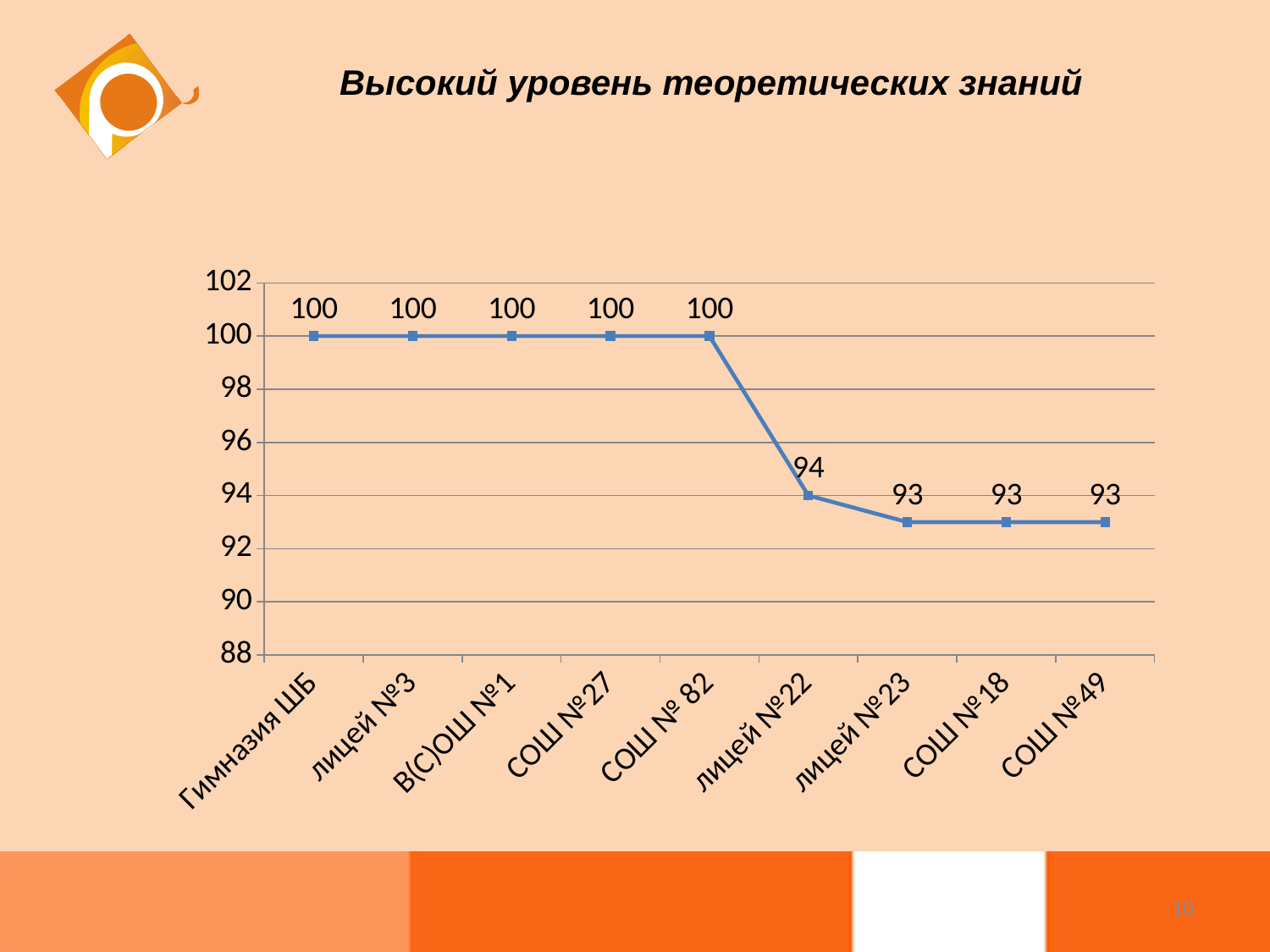
What is the difference between the values for лицей №22 and лицей №23? 1 What is the title of the slide? Высокий уровень теоретических знаний What kind of chart is shown on the slide? line chart What is the value for лицей №22? 94 How many categories are plotted on the x axis? 9 Which category has the lowest value among лицей №22, лицей №23 and СОШ №18? лицей №23 and СОШ №18 (both 93) Which is larger, the value for В(С)ОШ №1 or the value for СОШ №18? В(С)ОШ №1 What is the value for СОШ № 82? 100 Do the values rise or fall along the x axis from СОШ № 82 to СОШ №49? fall What is the value for СОШ №49? 93 What is the value for Гимназия ШБ? 100 What is the difference between the values for СОШ № 82 and лицей №22? 6